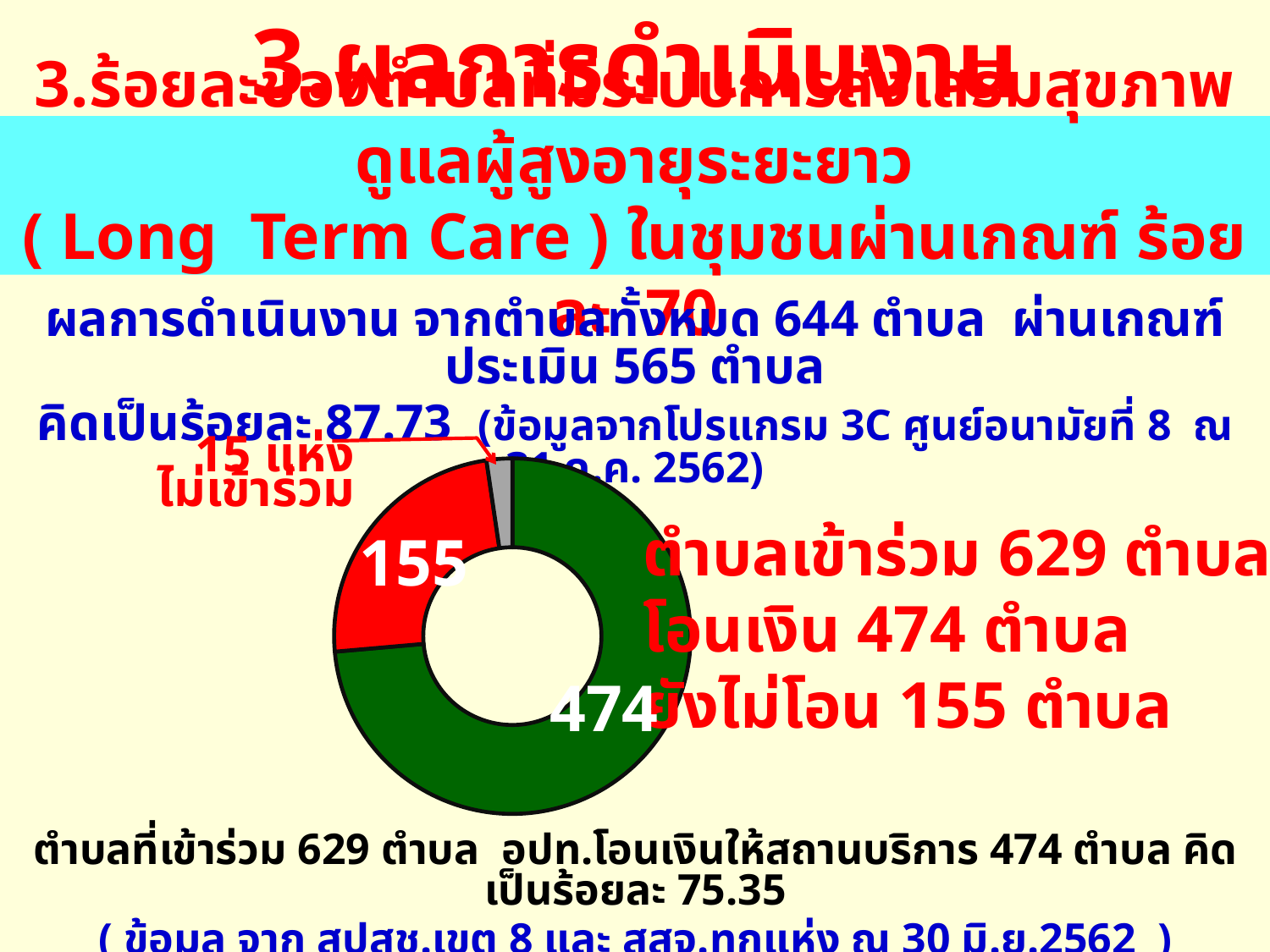
What is the total of all three slice values in the doughnut chart (474, 155 and 15)? 644 What value is labelled on the red slice of the doughnut chart? 155 What value is labelled on the green slice of the doughnut chart? 474 How many slices does the doughnut chart have? 3 What is the difference between the green slice value (474) and the red slice value (155)? 319 What colour is the slice labelled 474? Green Which is larger, the red slice or the grey slice? The red slice What is the difference between the red slice value (155) and the grey slice value (15)? 140 What kind of chart is shown on the slide? Doughnut chart Which slice of the doughnut chart has the smallest value? The grey slice (15 แห่ง ไม่เข้าร่วม) Which slice of the doughnut chart has the largest value? The green slice (474) How many แห่ง are labelled as ไม่เข้าร่วม on the small grey slice? 15 แห่ง